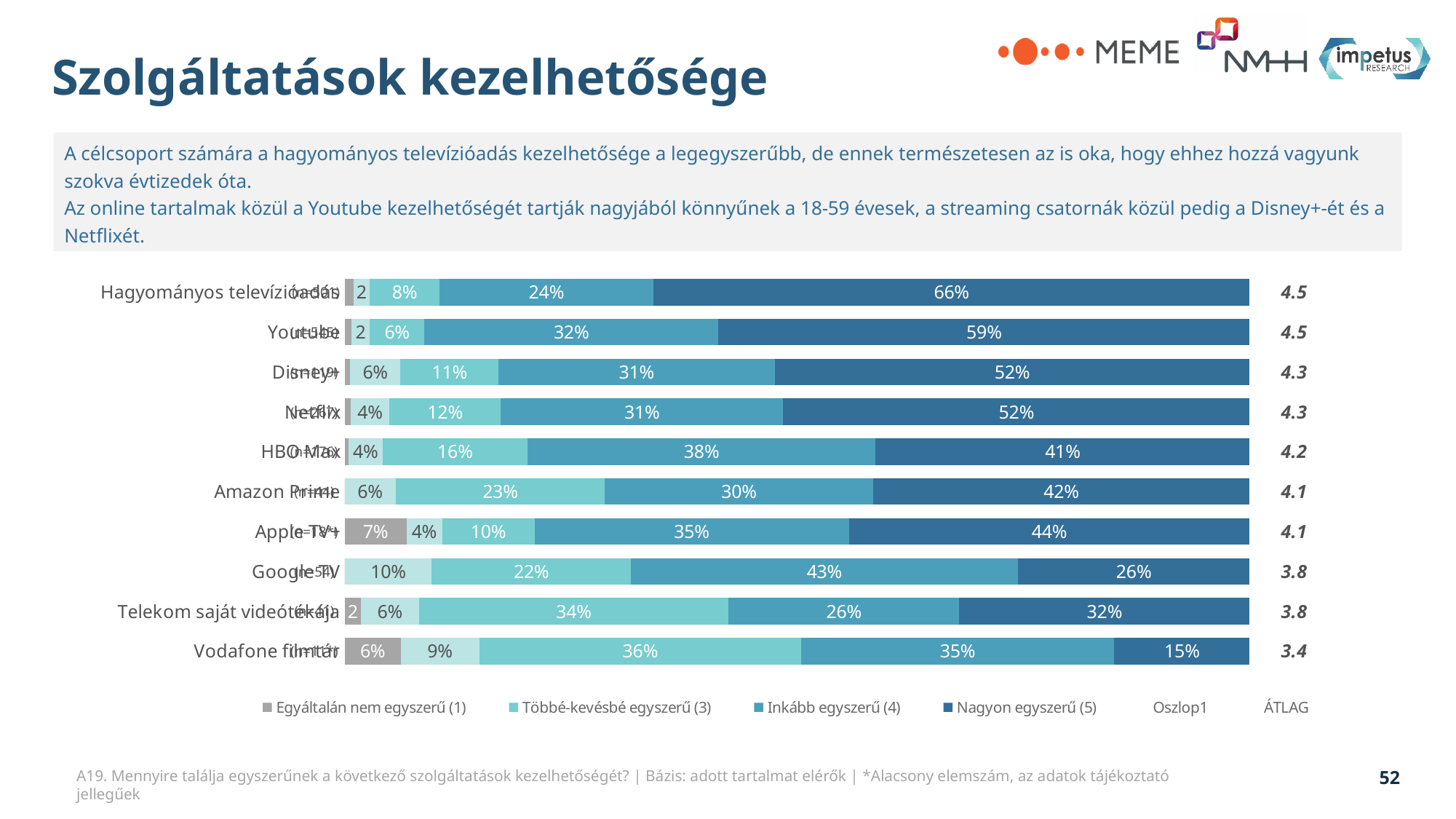
What is the Inkább egyszerű (4) value for Youtube? 32% What is the Többé-kevésbé egyszerű (3) value for Telekom saját videótéka? 34% What is the ÁTLAG (average) value shown for Vodafone filmtár? 3.4 What type of chart is shown on the slide? Stacked bar chart What is the Egyáltalán nem egyszerű (1) value for Apple TV+? 7% Which service has the lowest ÁTLAG value? Vodafone filmtár Which service has the highest Nagyon egyszerű (5) share? Hagyományos televízióadás How many services are listed in the chart? 10 What is the difference in percentage points between the Nagyon egyszerű (5) values of Hagyományos televízióadás and Youtube? 7 percentage points What percentage of respondents rated Hagyományos televízióadás as Nagyon egyszerű (5)? 66% Which has a larger Inkább egyszerű (4) value: Google TV or Vodafone filmtár? Google TV Which service has the lowest Nagyon egyszerű (5) share? Vodafone filmtár